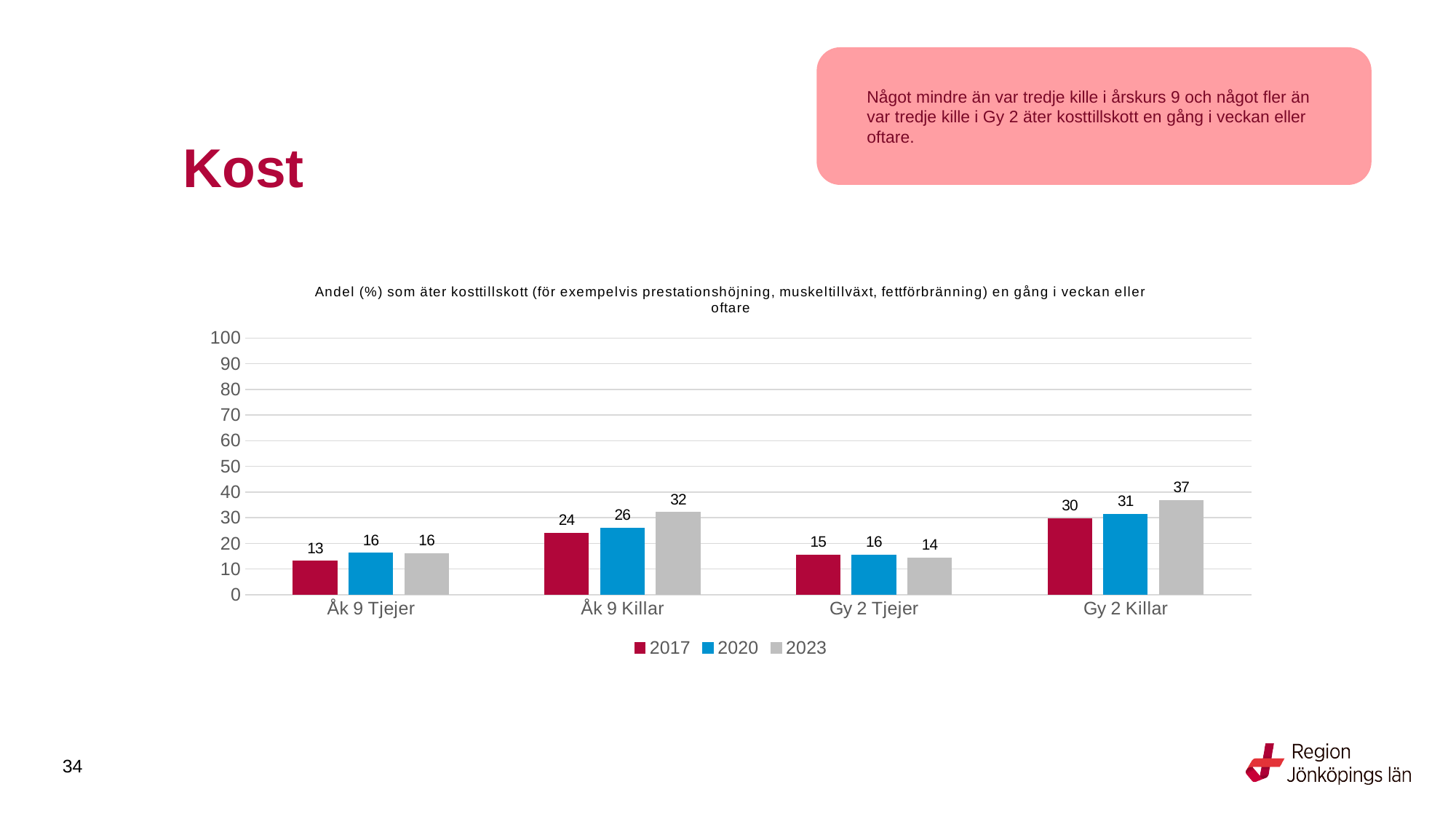
How many categories are shown on the x axis? 4 How many series does the legend list? 3 Which years are listed in the legend? 2017, 2020, 2023 What is the value for Gy 2 Killar in 2023? 37 Which category has the lowest value in the 2017 series? Åk 9 Tjejer Which is larger: the 2020 value for Åk 9 Killar or the 2020 value for Gy 2 Tjejer? Åk 9 Killar Which category has the highest value in the 2023 series? Gy 2 Killar What is the value for Åk 9 Tjejer in 2017? 13 What is the difference between the 2023 and 2017 values for Åk 9 Killar? 8 What kind of chart is shown on the slide? Bar chart Is the 2023 value for Gy 2 Killar greater or less than 40? less What is the value for Gy 2 Tjejer in 2020? 16